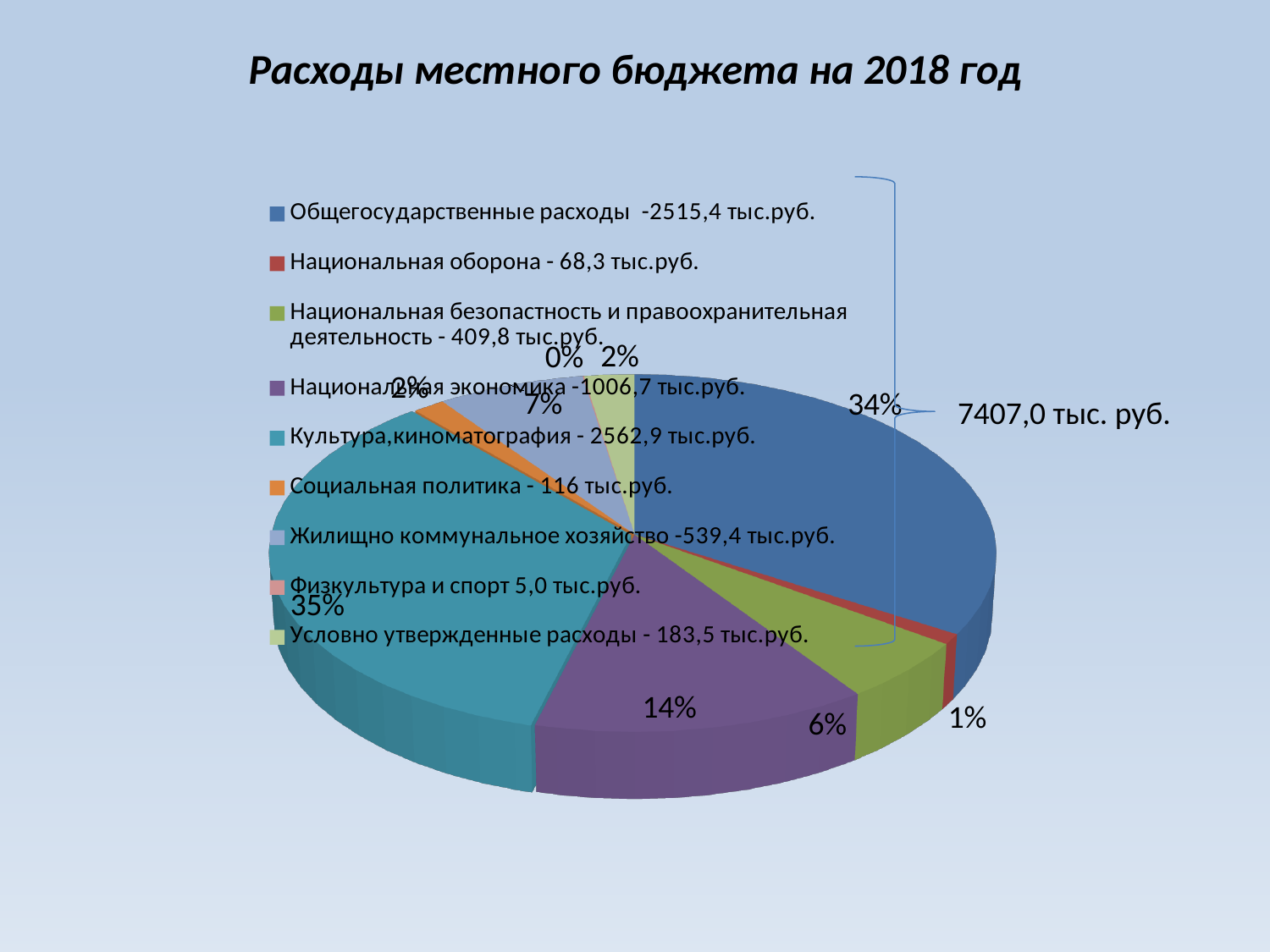
What is the value for Общегосударственные расходы? 2515,4 тыс.руб. What kind of chart is shown on the slide? pie chart Which category has the largest share of the pie? Культура,киноматография What is the title of the chart? Расходы местного бюджета на 2018 год What share of the pie does Национальная экономика represent? 14% How many categories does the pie chart have? 9 Which category has the smallest value? Физкультура и спорт What is the value for Национальная экономика? 1006,7 тыс.руб. What share of the pie does Национальная безопастность и правоохранительная деятельность represent? 6% What is the value for Жилищно коммунальное хозяйство? 539,4 тыс.руб. Which is larger, Социальная политика or Национальная оборона? Социальная политика What is the difference between Культура,киноматография and Общегосударственные расходы? 47,5 тыс.руб.